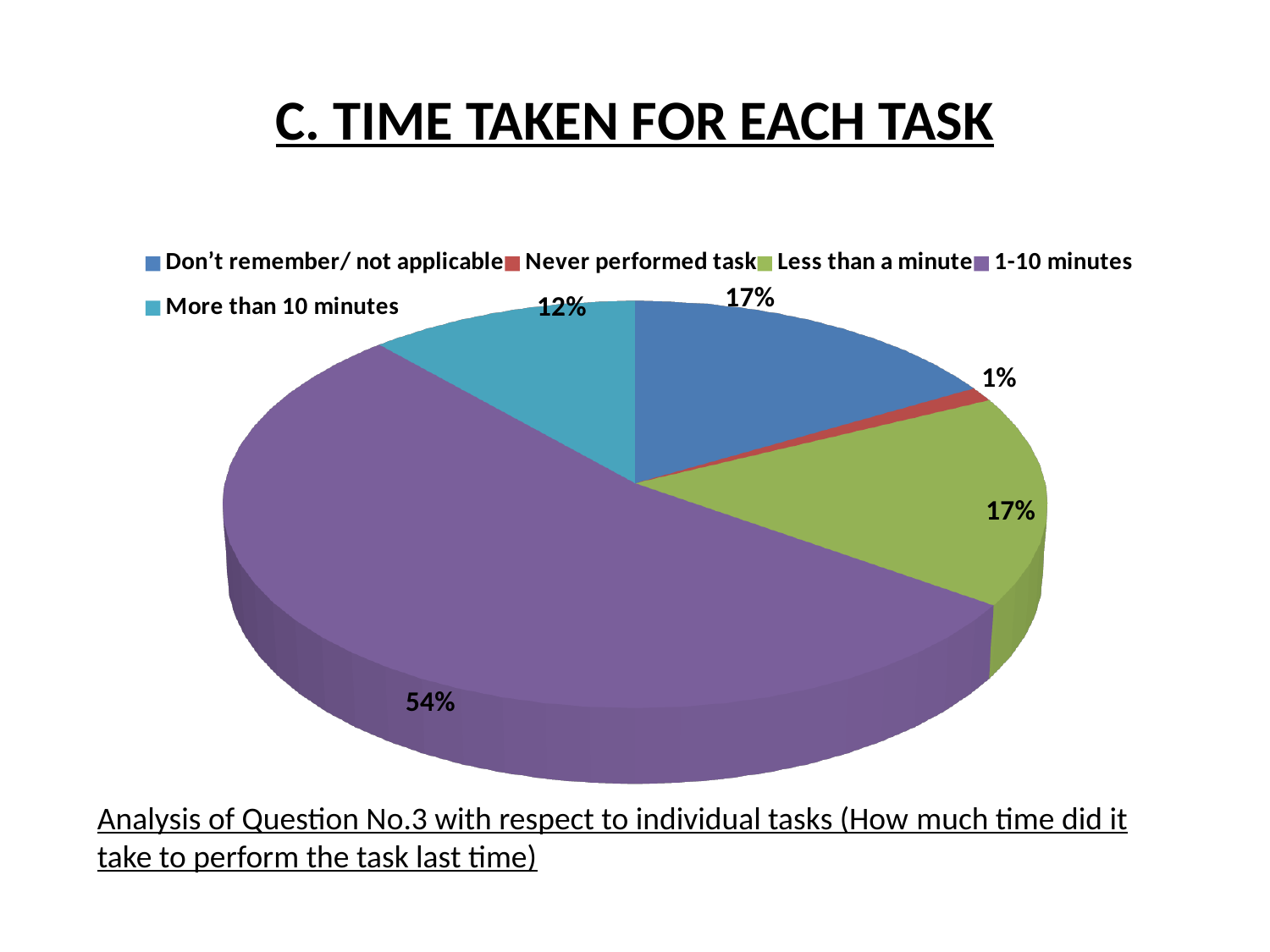
Which category has the largest share of the pie? 1-10 minutes What share of the pie does the '1-10 minutes' slice represent? 54% What is the difference in percentage points between '1-10 minutes' and 'More than 10 minutes'? 42 What percentage is shown for 'More than 10 minutes'? 12% What is the title of the slide containing the chart? C. TIME TAKEN FOR EACH TASK How many categories does the legend list? 5 What percentage is shown for 'Never performed task'? 1% Which category has the smallest share of the pie? Never performed task What percentage is shown for 'Don't remember/ not applicable'? 17% What kind of chart is shown on the slide? Pie chart What percentage is shown for 'Less than a minute'? 17% Which is larger, the share for 'More than 10 minutes' or the share for 'Less than a minute'? Less than a minute